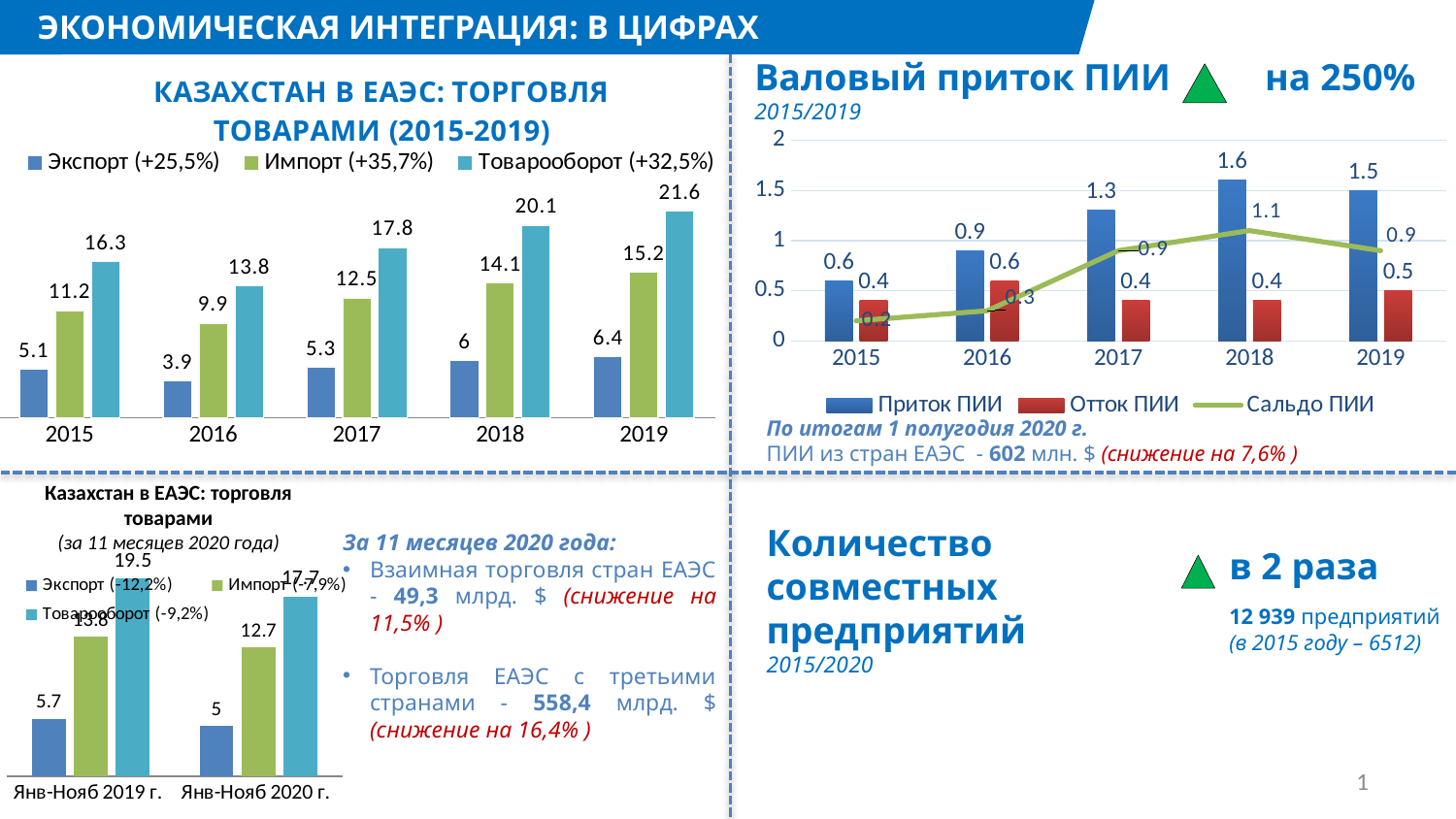
In the chart 'Валовый приток ПИИ', is Приток ПИИ in 2017 larger or smaller than Приток ПИИ in 2019? smaller In the chart 'Валовый приток ПИИ', which year has the highest Приток ПИИ? 2018 In the chart 'КАЗАХСТАН В ЕАЭС: ТОРГОВЛЯ ТОВАРАМИ (2015-2019)', what is the difference between Импорт in 2019 and Импорт in 2015? 4 In the bottom-left chart 'Казахстан в ЕАЭС: торговля товарами (за 11 месяцев 2020 года)', what is the difference between Импорт for Янв-Нояб 2019 г. and Янв-Нояб 2020 г.? 1.1 In the chart 'КАЗАХСТАН В ЕАЭС: ТОРГОВЛЯ ТОВАРАМИ (2015-2019)', how many series does the legend list? 3 In the chart 'КАЗАХСТАН В ЕАЭС: ТОРГОВЛЯ ТОВАРАМИ (2015-2019)', what is the value of Товарооборот for 2019? 21.6 In the chart 'Валовый приток ПИИ', what is the value of Приток ПИИ for 2018? 1.6 In the chart 'КАЗАХСТАН В ЕАЭС: ТОРГОВЛЯ ТОВАРАМИ (2015-2019)', which year has the lowest Экспорт value? 2016 In the chart 'Валовый приток ПИИ', what is the value of Отток ПИИ for 2016? 0.6 In the chart 'Валовый приток ПИИ', how many years are shown on the x axis? 5 In the chart 'КАЗАХСТАН В ЕАЭС: ТОРГОВЛЯ ТОВАРАМИ (2015-2019)', what is the value of Экспорт for 2016? 3.9 In the bottom-left chart 'Казахстан в ЕАЭС: торговля товарами (за 11 месяцев 2020 года)', what is the value of Товарооборот for Янв-Нояб 2020 г.? 17.7